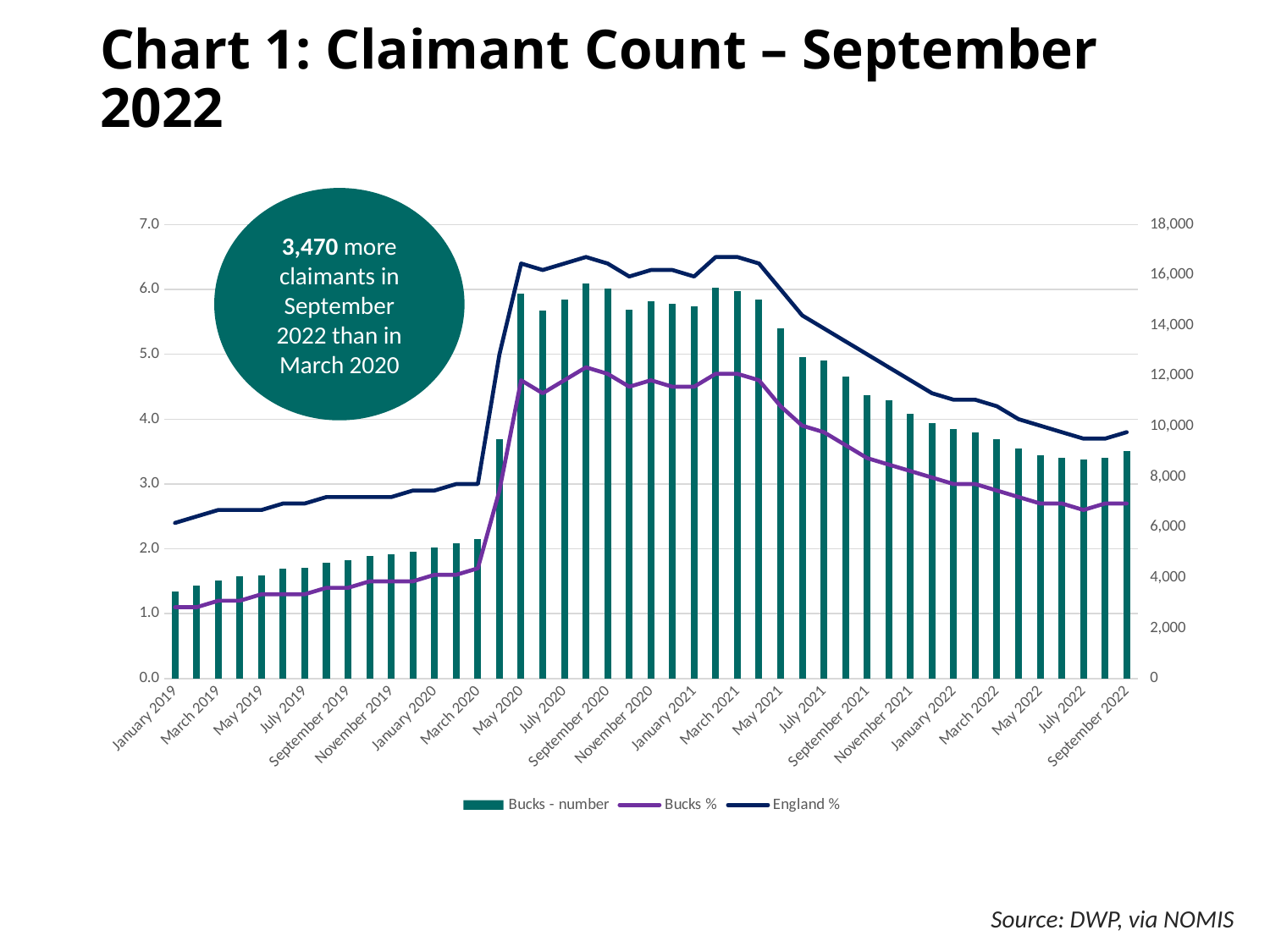
Do the Bucks - number bars rise or fall from March 2021 to September 2022? fall Is the England % value for May 2020 greater or less than 6.0? greater Is the Bucks - number value for January 2019 greater or less than 4,000? less According to the callout on the chart, how many more claimants were there in September 2022 than in March 2020? 3,470 Which month has the lowest Bucks - number bar? January 2019 Is the Bucks - number value for September 2022 greater or less than 10,000? less What are the three series named in the legend? Bucks - number, Bucks %, England % How many series does the legend list? 3 In September 2022, which is higher: Bucks % or England %? England % What kind of chart is shown on the slide? A combination of a bar chart and line chart